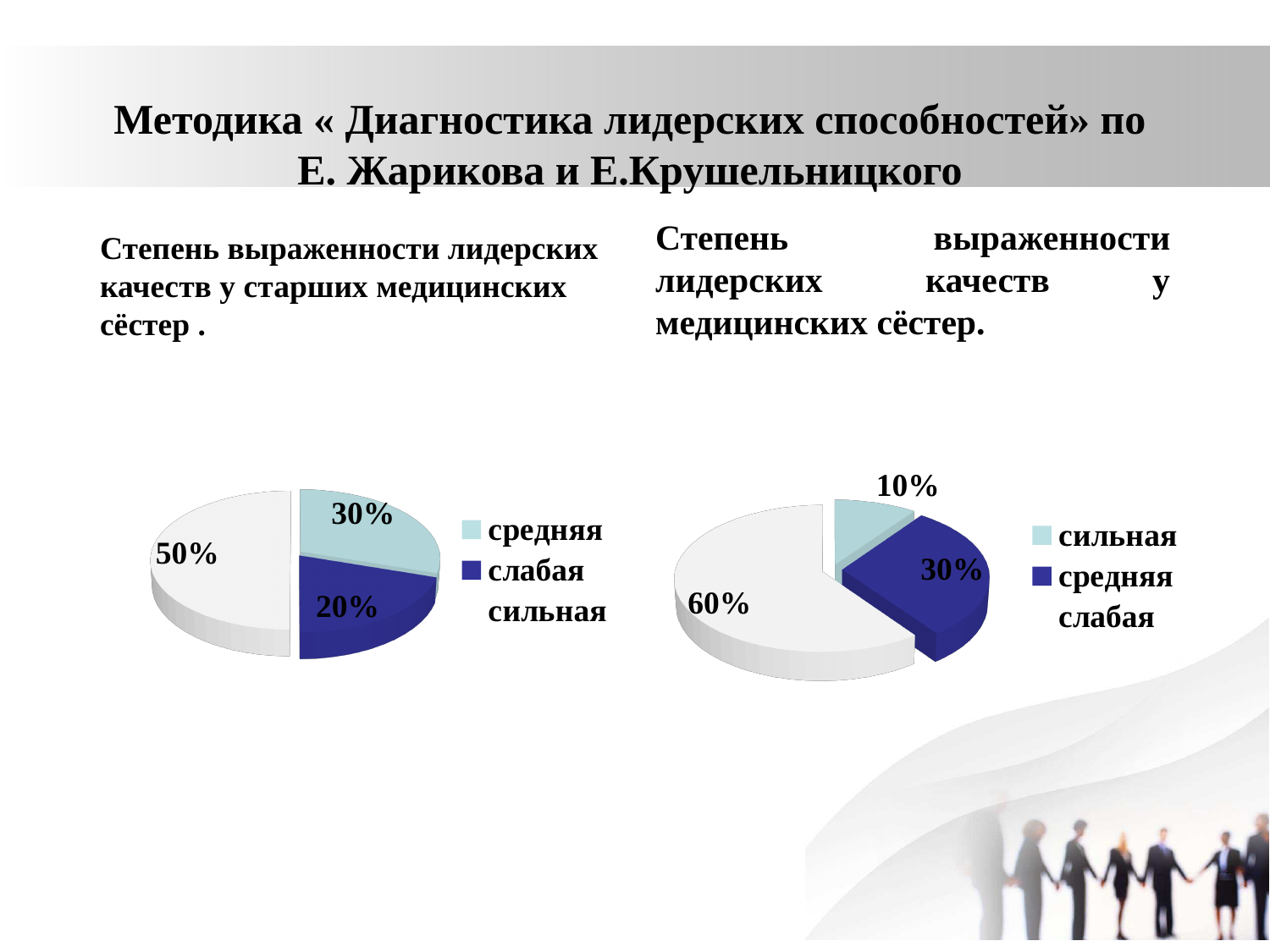
In the left pie chart (senior nurses), which category has the largest slice? сильная In the left pie chart (senior nurses), what share is labelled for the 'сильная' slice? 50% In the right pie chart (nurses), what share is labelled for the 'слабая' slice? 60% In the left pie chart (senior nurses), what share is labelled for the 'средняя' slice? 30% In the right pie chart (nurses), which category has the largest slice? слабая In the left pie chart (senior nurses), what share is labelled for the 'слабая' slice? 20% In the left pie chart (senior nurses), what is the difference between the 'сильная' and 'слабая' shares? 30% In the right pie chart (nurses), what share is labelled for the 'сильная' slice? 10% How many slices does the left pie chart (senior nurses) have? 3 In the right pie chart (nurses), which is larger: the 'средняя' slice or the 'сильная' slice? средняя What type of chart is used on the right side of the slide? Pie chart In the right pie chart (nurses), which category has the smallest slice? сильная